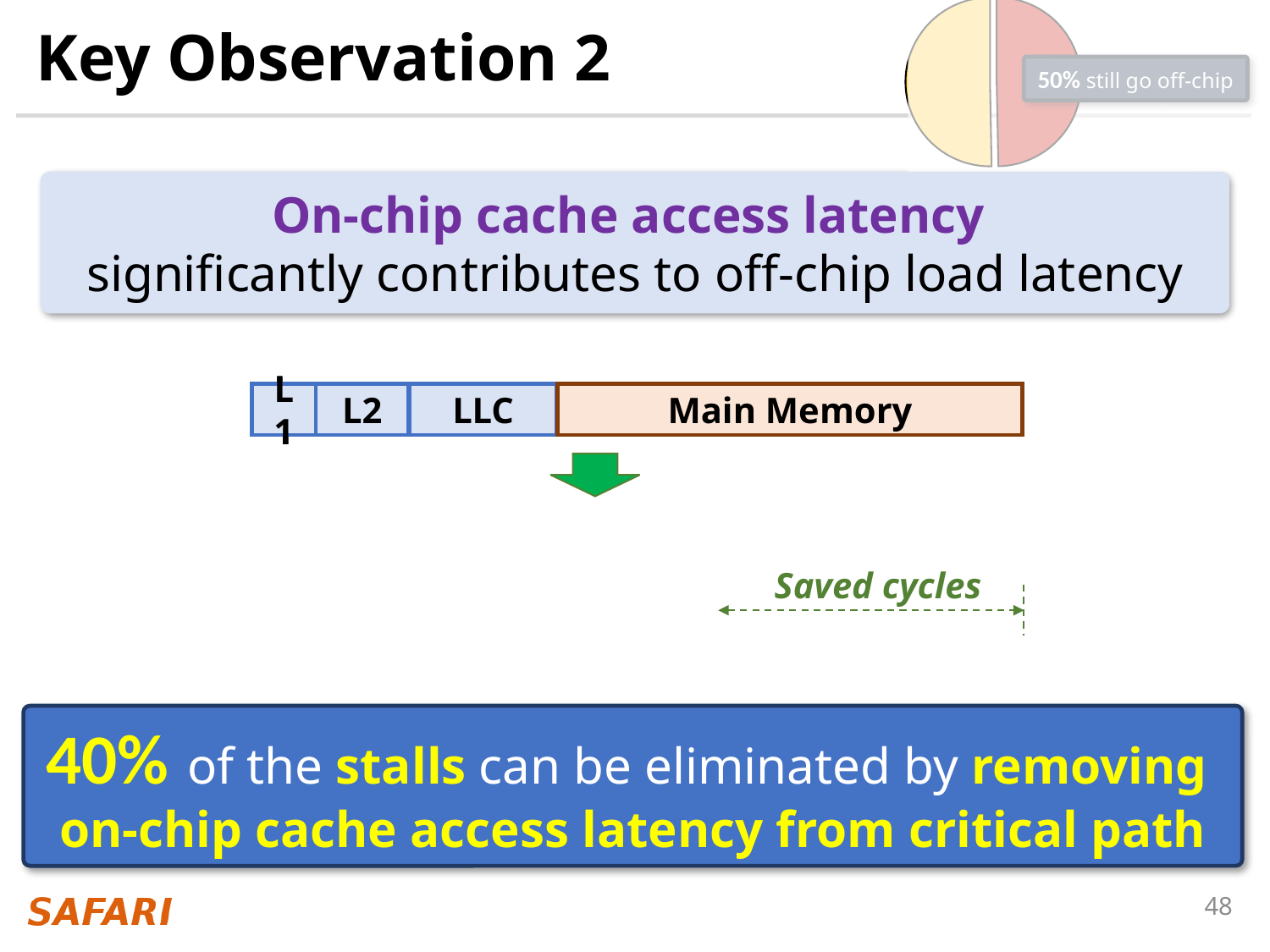
In the pie chart in the top right, what colour is the slice labelled "50% still go off-chip"? red What kind of chart is shown in the top right corner of the slide? pie chart How many slices does the pie chart in the top right have? 2 In the pie chart in the top right, what share of loads still go off-chip? 50% What is the label attached to the red slice of the pie chart in the top right? 50% still go off-chip